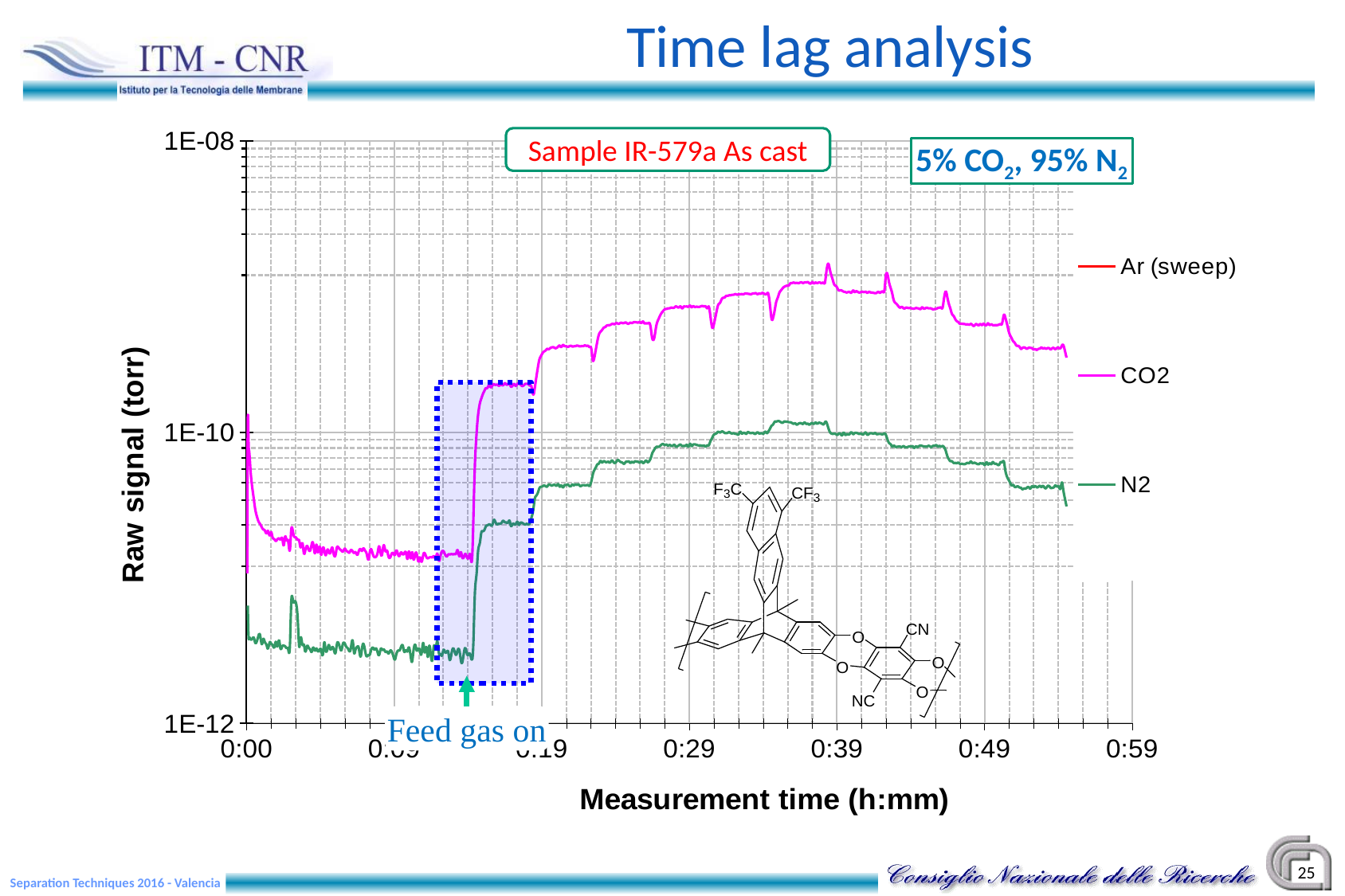
Is the N2 raw signal at 0:05 greater or less than 1E-10 torr? less What kind of chart is shown on the slide? line chart What is the label of the x axis? Measurement time (h:mm) Does the CO2 signal rise or fall between 0:45 and 0:55? fall Does the N2 signal rise or fall between 0:19 and 0:39? rise Which series has the highest signal at 0:39? CO2 Is the CO2 raw signal at 0:05 greater or less than 1E-10 torr? less Is the CO2 raw signal at 0:39 greater or less than 1E-10 torr? greater What is the label of the y axis? Raw signal (torr) How many series does the chart legend list? 3 Which of the two plotted series, CO2 or N2, has the larger raw signal at 0:29? CO2